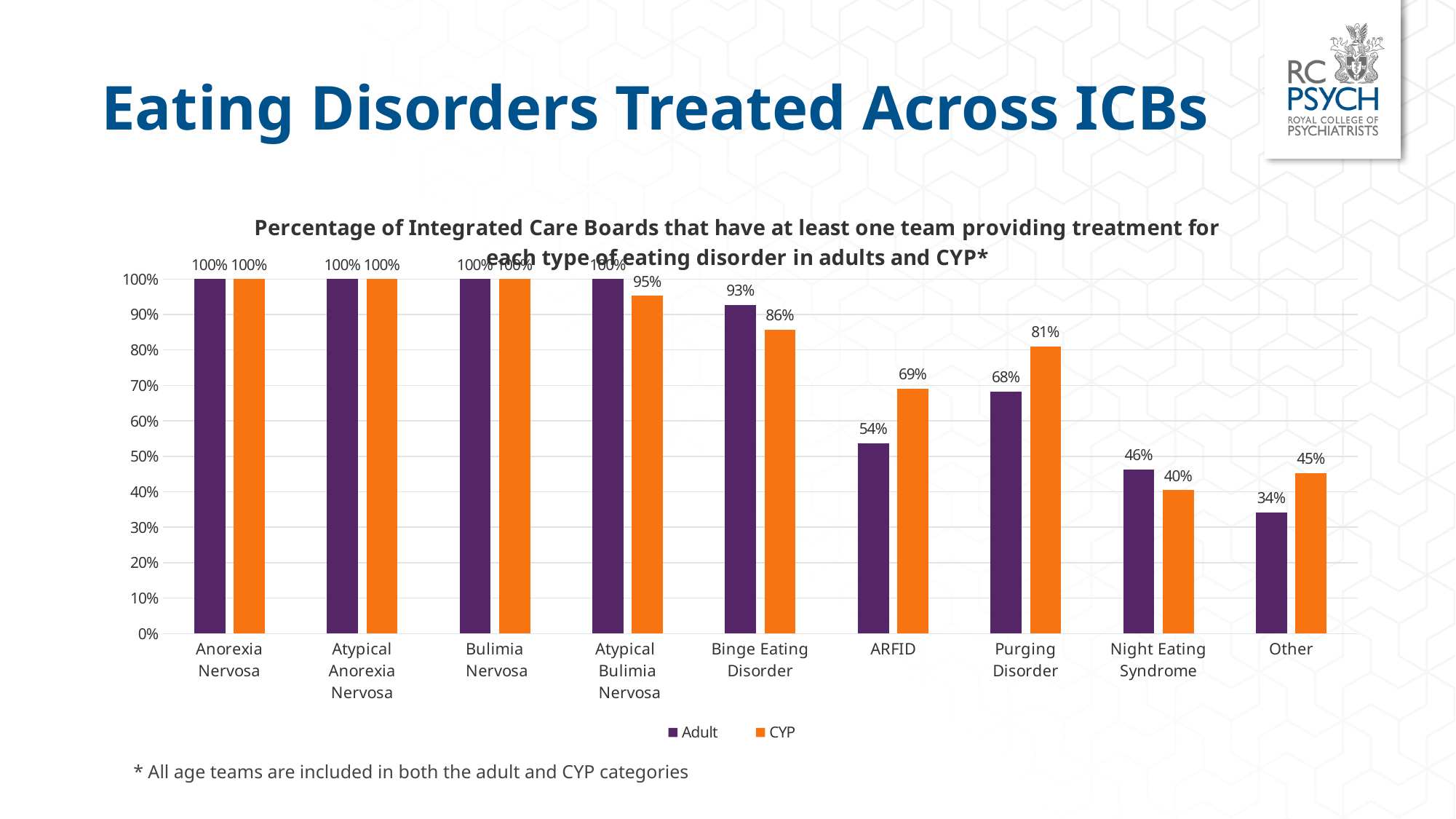
What kind of chart is shown on the slide? Bar chart Which category has the lowest Adult value? Other What is the CYP value for Binge Eating Disorder? 86% What is the Adult value for Other? 34% How many series does the legend list? 2 Which category has the lowest CYP value? Night Eating Syndrome How many eating disorder categories are shown on the x axis? 9 What is the Adult value for ARFID? 54% What is the difference between the Adult and CYP values for Night Eating Syndrome? 6% What is the CYP value for Purging Disorder? 81% Which is larger for Purging Disorder, the Adult value or the CYP value? CYP What is the difference between the CYP and Adult values for ARFID? 15%